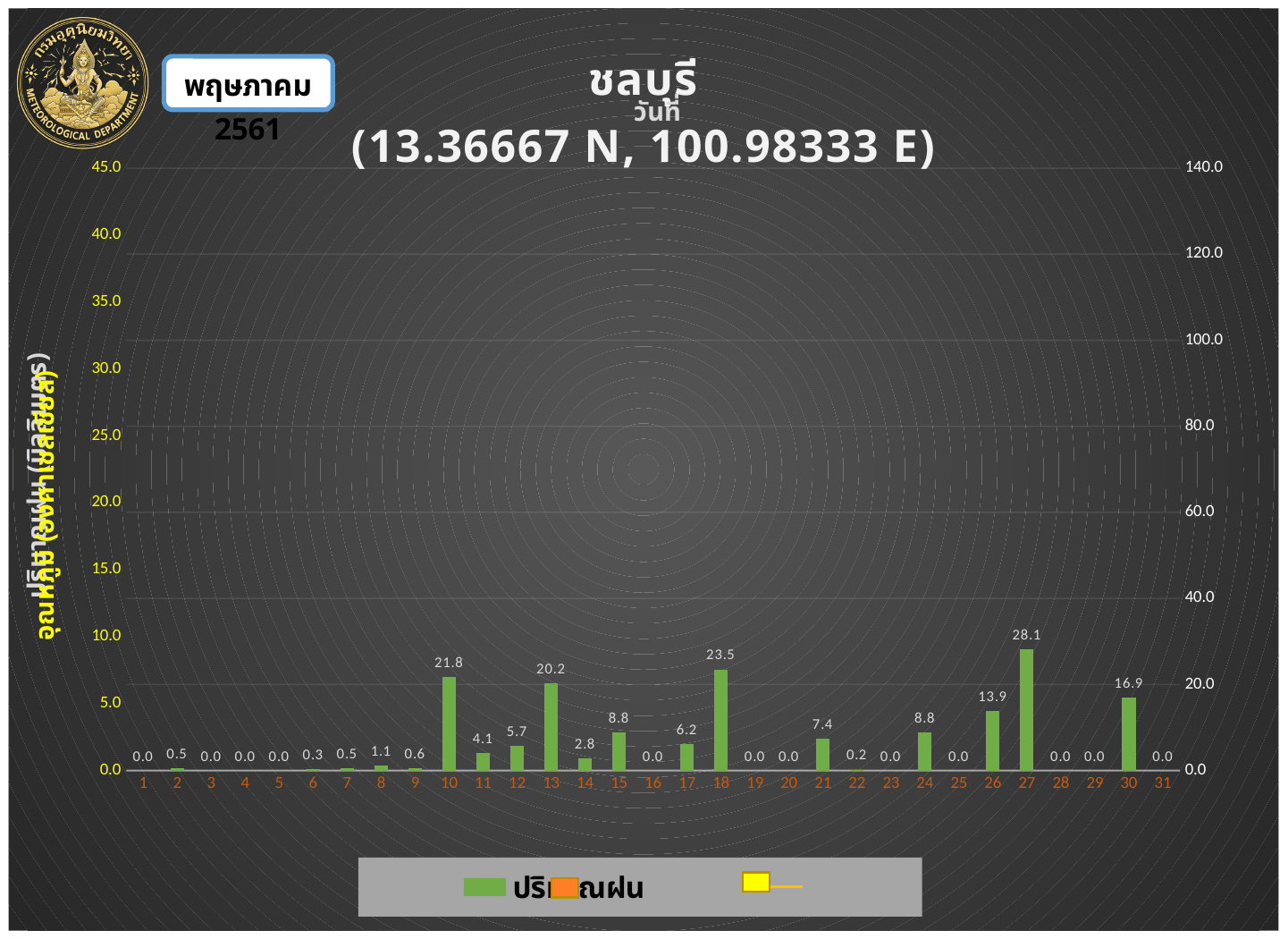
What is the difference between the values for day 10 and day 13? 1.6 Which day has the highest bar in the chart? 27 What kind of chart is shown on the slide? bar chart Which is larger, the value for day 10 or the value for day 13? day 10 How many days are shown along the x axis? 31 What is the station name given in the chart title? ชลบุรี What is the difference between the values for day 27 and day 18? 4.6 What is the value labelled for day 18? 23.5 What is the value labelled for day 10? 21.8 Is the value for day 27 greater or less than 20.0 on the right-hand axis? greater What is the value labelled for day 30? 16.9 What is the rainfall value shown for day 27? 28.1